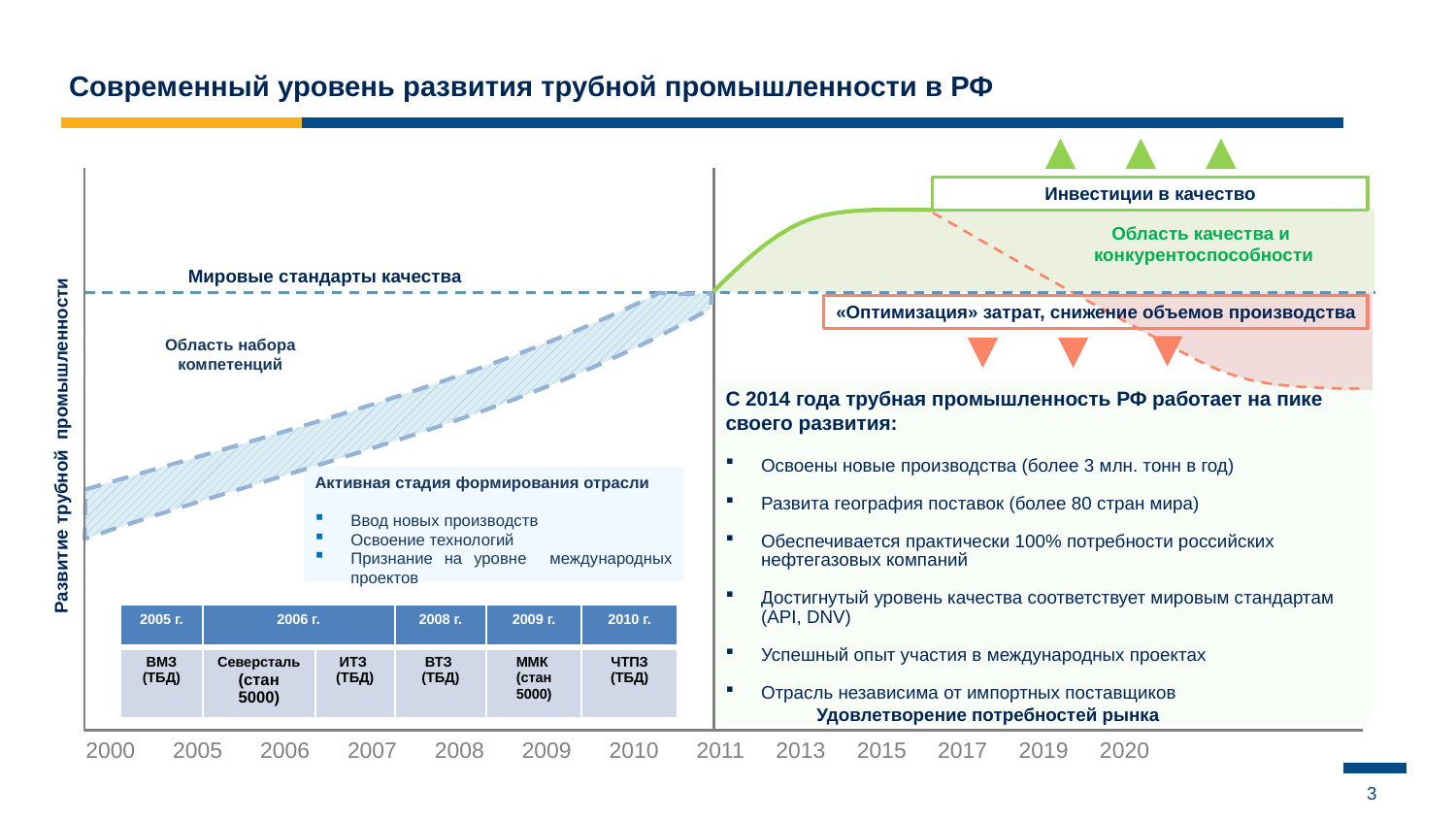
What label is given to the horizontal dashed line in the diagram? Мировые стандарты качества What is the last year label on the x axis? 2020 In the table inside the diagram, which year is ВМЗ (ТБД) listed under? 2005 г. In the table inside the diagram, how many companies are listed under 2006 г.? 2 How many year labels are shown along the x axis of the diagram? 13 After about 2015, does the red dashed curve leading to the area «Оптимизация» затрат, снижение объемов производства rise or fall? fall From 2011 to about 2015, does the green curve rise or fall? rise What is the label of the vertical axis? Развитие трубной промышленности In the table inside the diagram, which year is ЧТПЗ (ТБД) listed under? 2010 г. Along the x axis from 2000 to 2011, does the hatched band labelled «Область набора компетенций» rise or fall? rise What is the first year label on the x axis? 2000 From which year does the slide say the Russian pipe industry has been working at the peak of its development? 2014